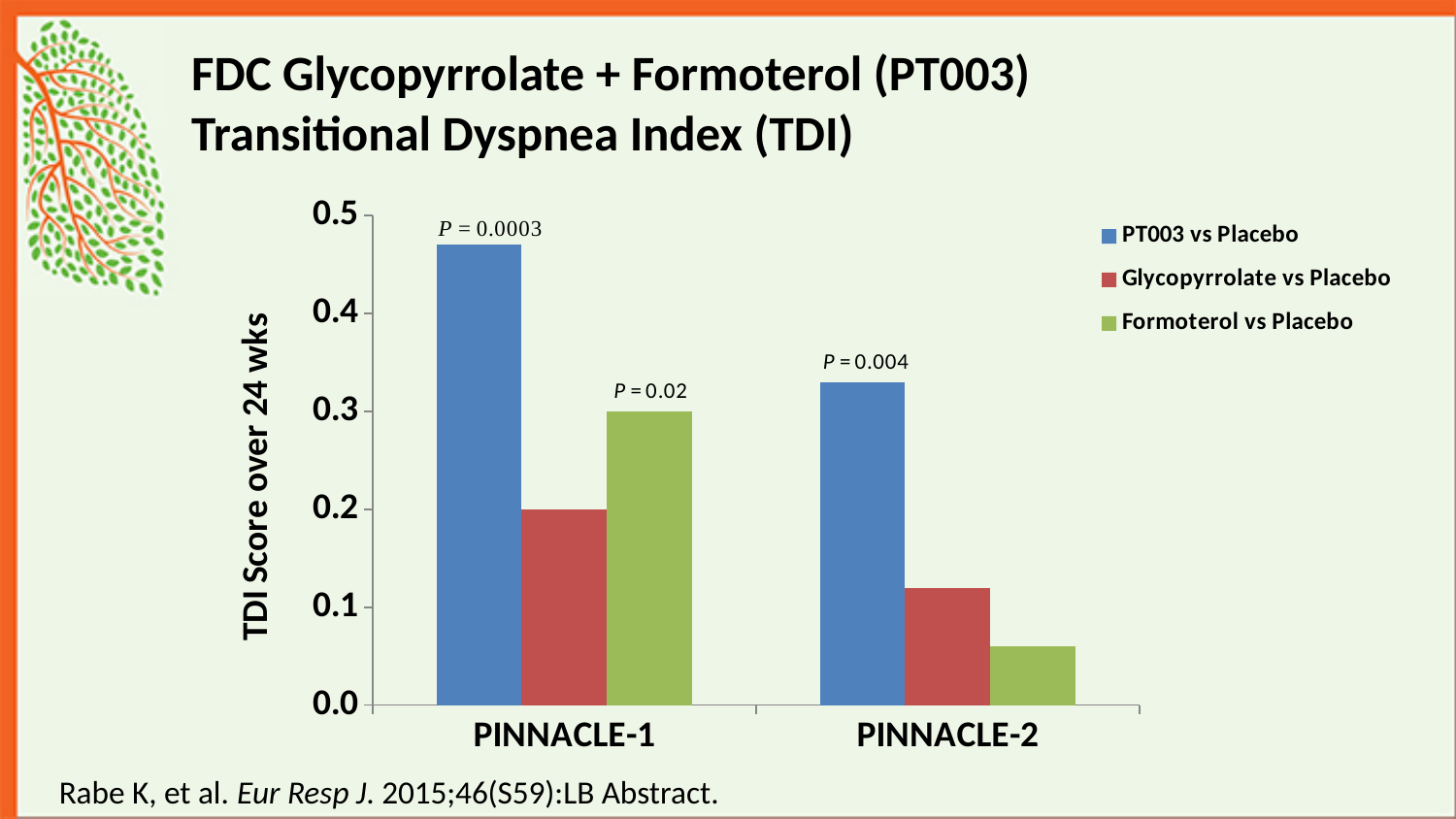
Is the TDI score for PT003 vs Placebo in PINNACLE-1 greater or less than 0.4? greater Which series has the lowest TDI score in PINNACLE-2? Formoterol vs Placebo Which is larger: the TDI score for Glycopyrrolate vs Placebo in PINNACLE-1 or in PINNACLE-2? PINNACLE-1 Is the TDI score for Formoterol vs Placebo in PINNACLE-2 greater or less than 0.1? less Is the TDI score for PT003 vs Placebo in PINNACLE-2 greater or less than 0.3? greater Which is larger in PINNACLE-1: the TDI score for Glycopyrrolate vs Placebo or Formoterol vs Placebo? Formoterol vs Placebo Which series has the highest TDI score in PINNACLE-1? PT003 vs Placebo What is the label of the y axis? TDI Score over 24 wks How many series does the legend list? 3 What P value is printed above the PT003 vs Placebo bar for PINNACLE-1? P = 0.0003 How many study categories are shown on the x axis? 2 What kind of chart is shown on the slide? bar chart